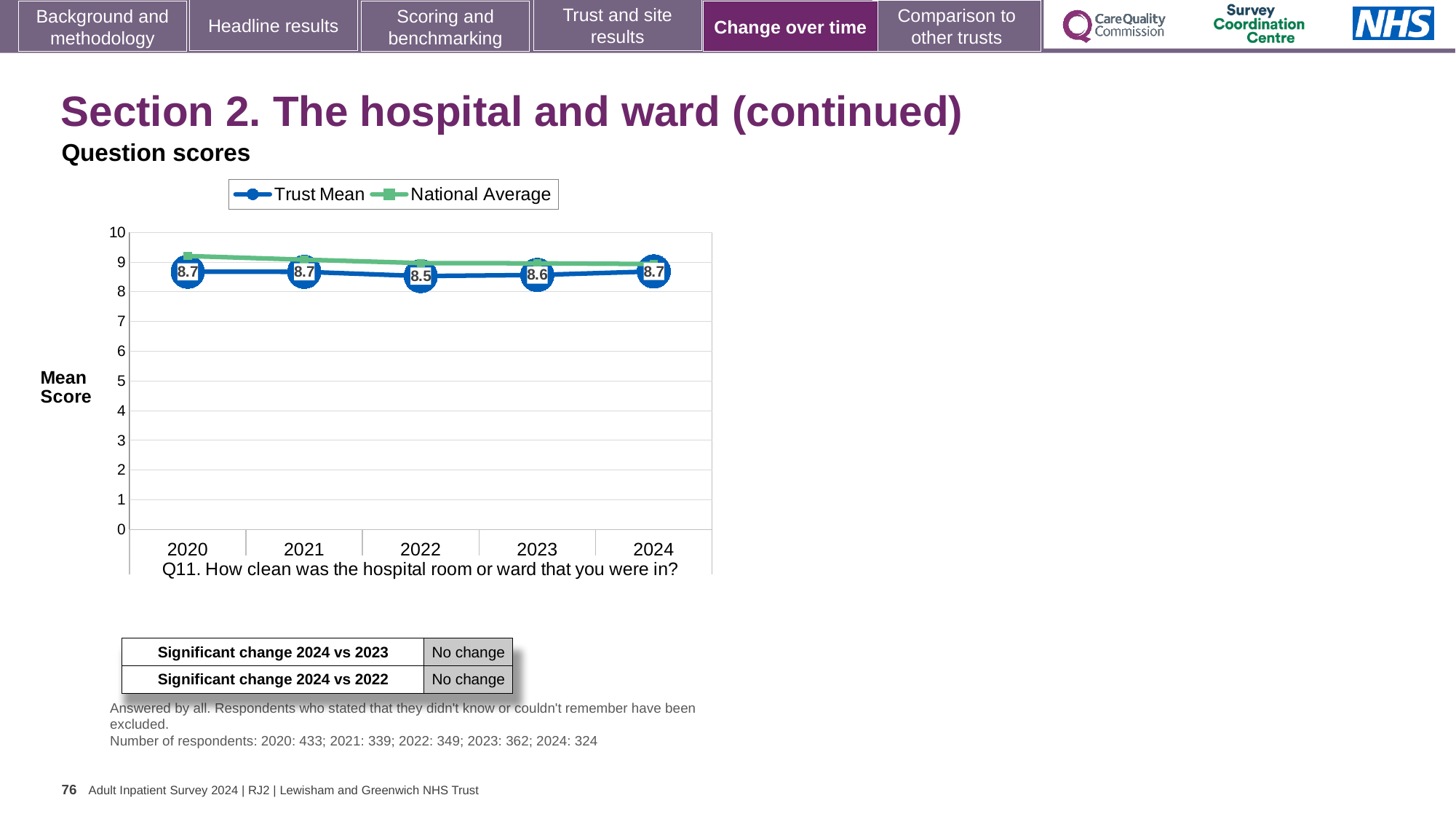
Which year has the higher Trust Mean score, 2022 or 2023? 2023 In which year is the Trust Mean score lowest? 2022 What kind of chart is shown on the slide? line chart What is the Trust Mean score for 2024? 8.7 How many years are plotted on the x axis? 5 Which survey question does the chart show scores for? Q11. How clean was the hospital room or ward that you were in? Is the National Average value for 2022 greater or less than 8? greater How many series does the legend list? 2 What is the Trust Mean score for 2023? 8.6 What is the difference between the Trust Mean scores for 2020 and 2022? 0.2 Does the Trust Mean score rise or fall from 2022 to 2024? rise What is the Trust Mean score for 2022? 8.5